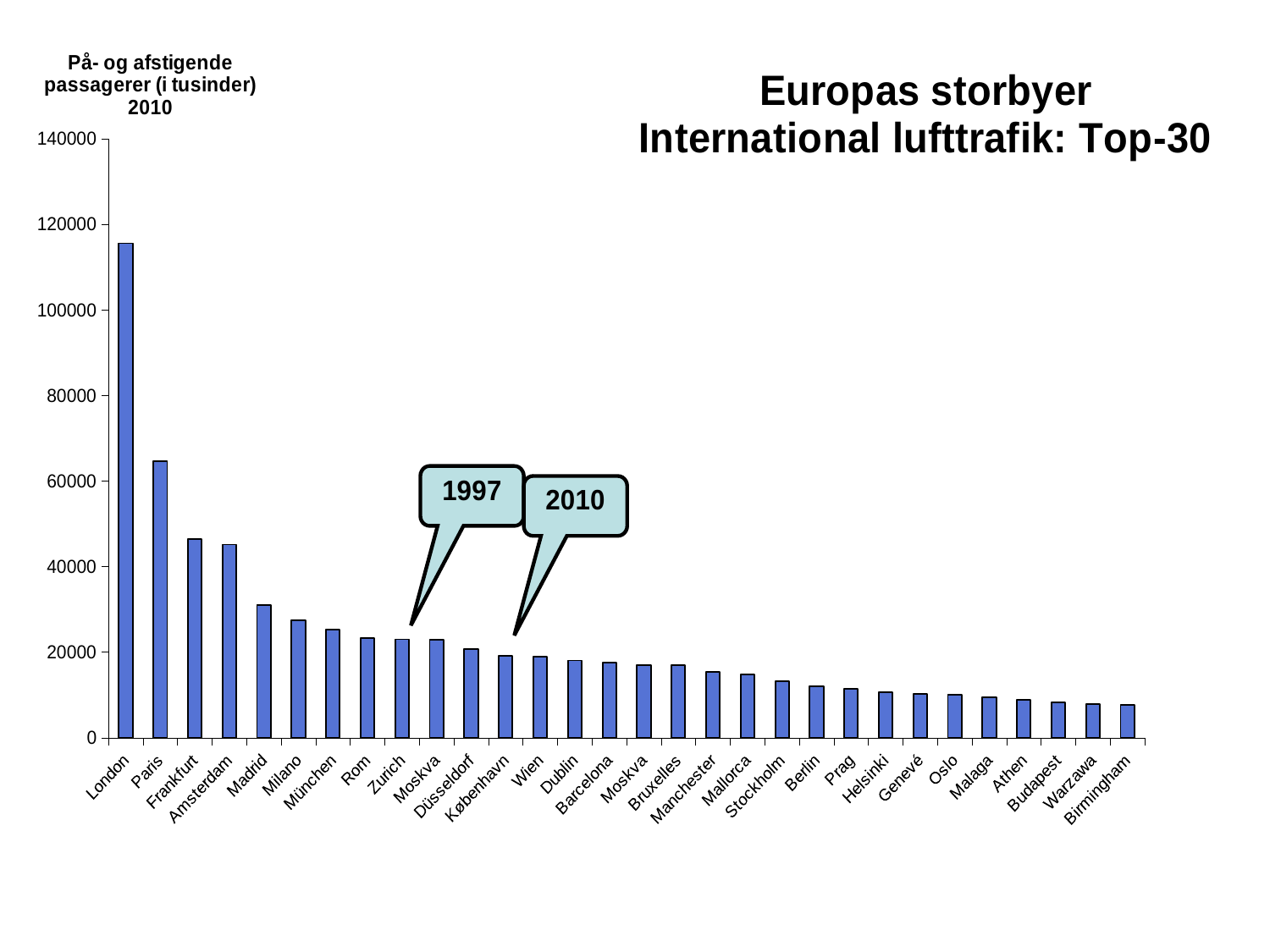
Is the value for Madrid greater or less than 20000? greater What kind of chart is shown on the slide? bar chart Which has a higher value, Madrid or Stockholm? Madrid Is the value for London greater or less than 100000? greater What is the title of the chart on the slide? Europas storbyer International lufttrafik: Top-30 Is the value for Berlin greater or less than 20000? less Which city has the lowest number of passengers in the chart? Birmingham Which has a higher value, Paris or Frankfurt? Paris Do the values rise or fall moving from left to right along the x axis? fall How many cities are shown on the x axis of the chart? 30 Which city has the highest number of passengers in the chart? London